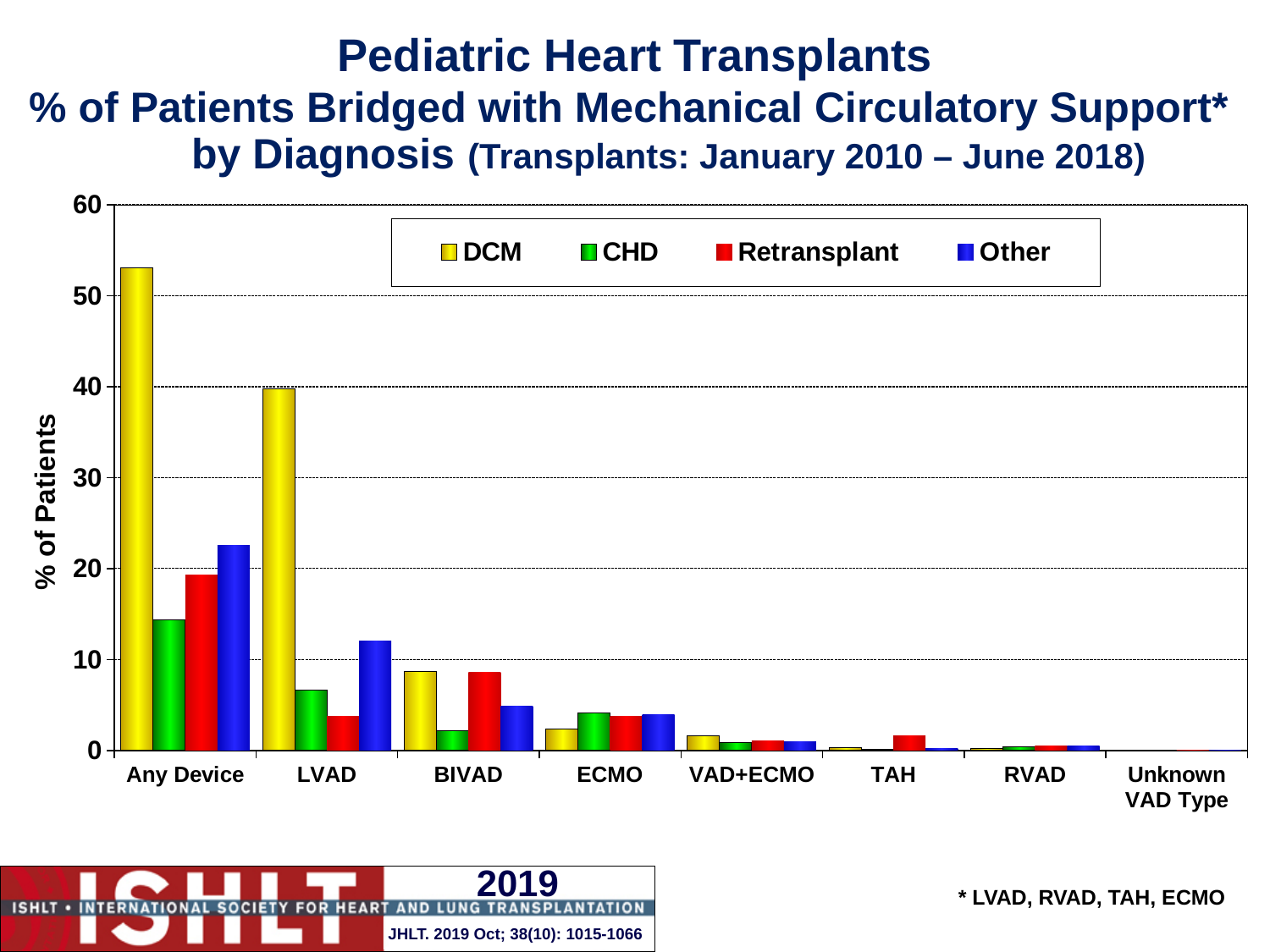
For Any Device, which is larger: the Other value or the CHD value? Other Which device category has the highest DCM value? Any Device Is the CHD value for LVAD greater or less than 10? less How many device categories are shown on the x axis? 8 For LVAD, which is larger: the DCM value or the Other value? DCM What is the label of the y axis? % of Patients Is the Other value for Any Device greater or less than 20? greater How many series does the legend list? 4 What kind of chart is shown on the slide? bar chart Which diagnosis has the highest value for Any Device? DCM Is the DCM value for LVAD greater or less than 30? greater